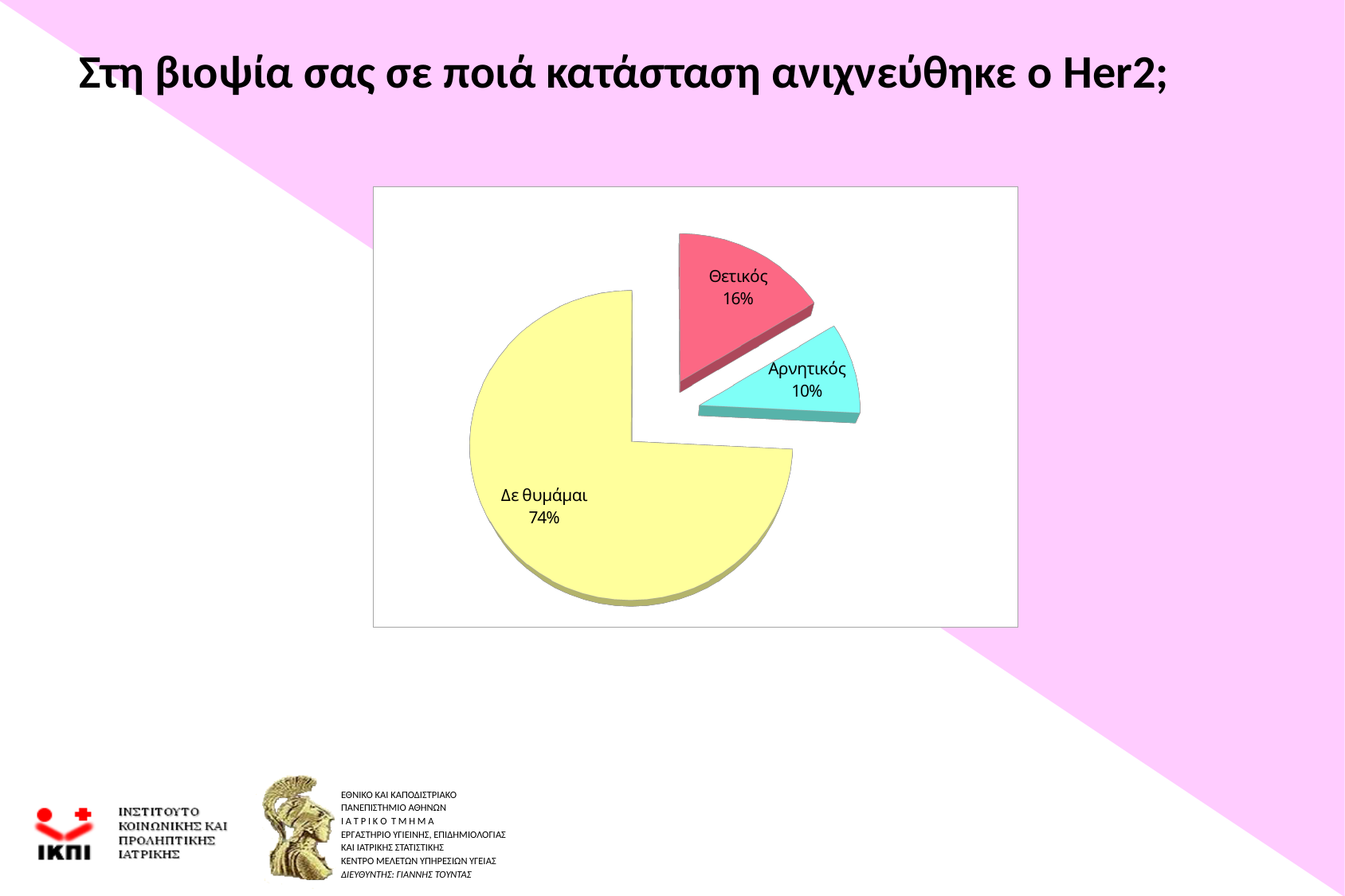
Which category has the largest share of the pie? Δε θυμάμαι What is the difference in percentage points between Δε θυμάμαι and Θετικός? 58 What colour is the Δε θυμάμαι slice? Yellow What percentage of respondents answered Αρνητικός? 10% Which is larger, the share for Θετικός or the share for Αρνητικός? Θετικός What percentage of respondents answered Θετικός? 16% What percentage of respondents answered Δε θυμάμαι? 74% What kind of chart is shown on the slide? Pie chart What is the difference in percentage points between Θετικός and Αρνητικός? 6 What is the combined share of Θετικός and Αρνητικός? 26% Which category has the smallest share of the pie? Αρνητικός How many categories are shown in the pie chart? 3